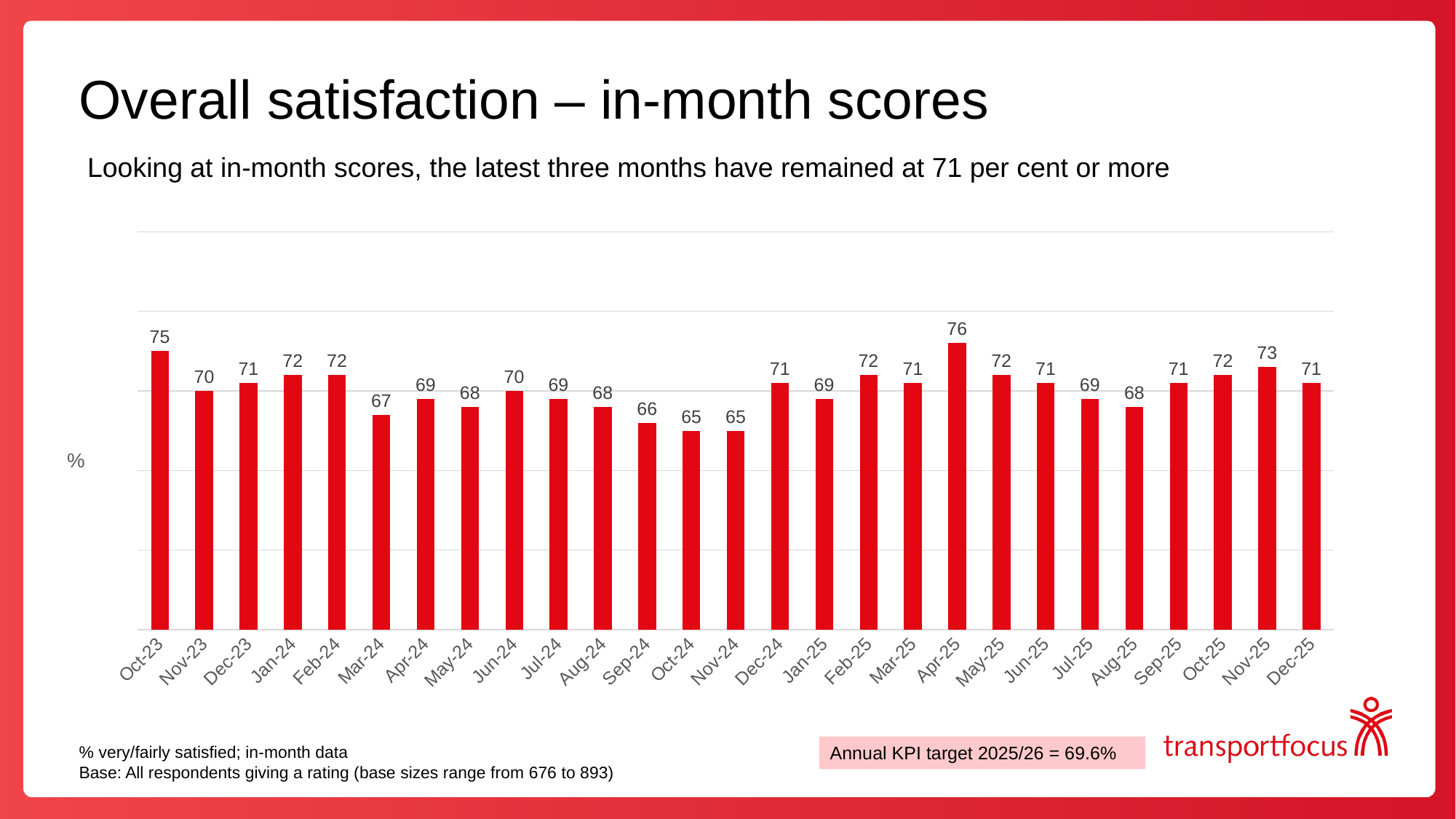
What is the overall satisfaction score for Sep-24? 66 Which month has the highest overall satisfaction score? Apr-25 Which is higher, the score for Mar-24 or the score for Jun-24? Jun-24 What is the overall satisfaction score for Dec-25? 71 What is the annual KPI target for 2025/26 stated on the slide? 69.6% What type of chart is shown on the slide? Bar chart What is the overall satisfaction score for Oct-23? 75 What is the overall satisfaction score for Apr-25? 76 What is the lowest overall satisfaction score shown on the chart? 65 What is the difference between the scores for Apr-25 and Oct-24? 11 What is the difference between the scores for Nov-25 and Aug-25? 5 How many months are plotted on the chart? 27